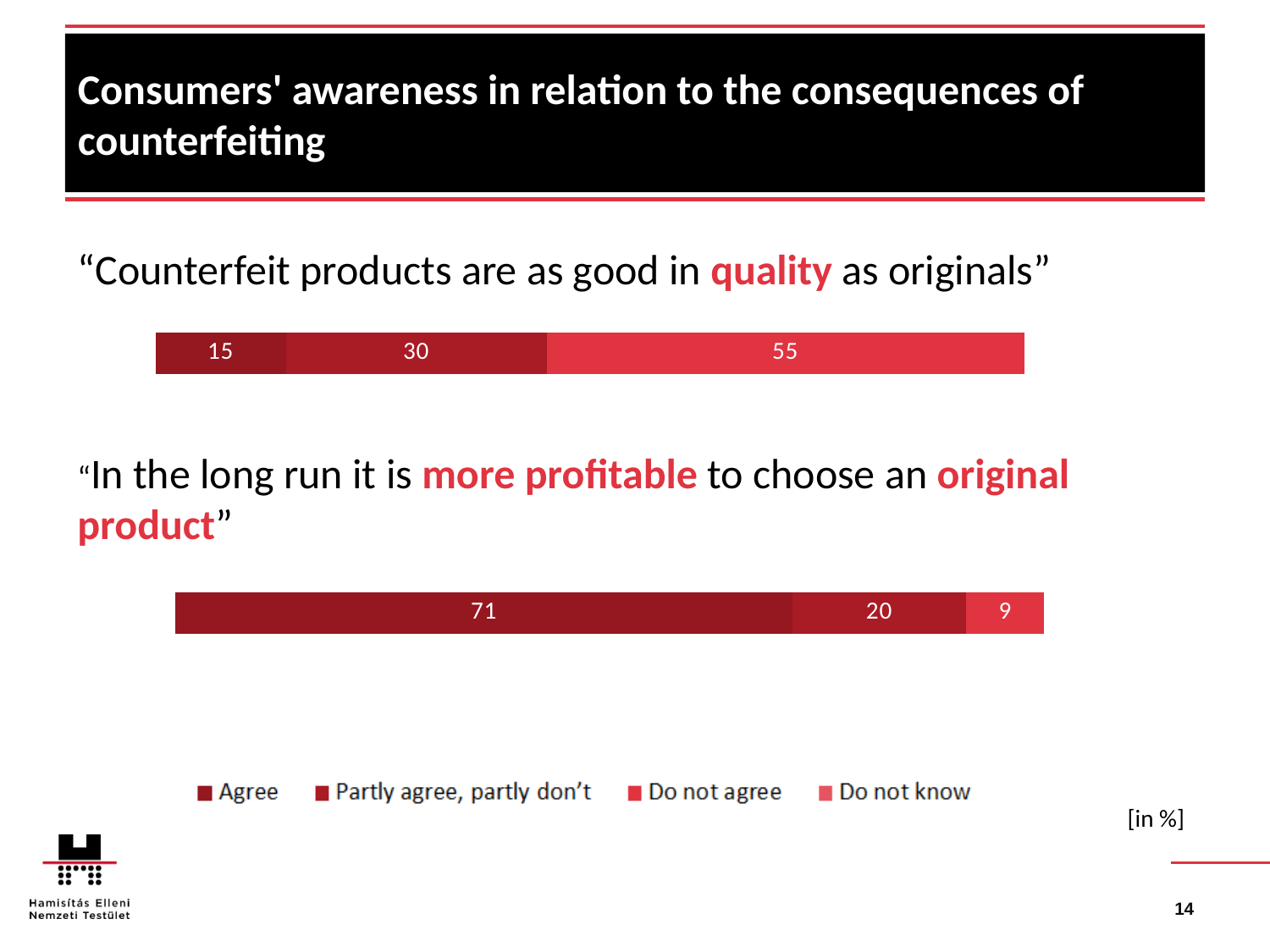
What is the total of the stacked bar in the chart for "In the long run it is more profitable to choose an original product"? 100 How many series does the legend at the bottom of the slide list? 4 Which is larger: the "Agree" value in the quality chart or the "Agree" value in the more profitable chart? The more profitable chart In the chart for "In the long run it is more profitable to choose an original product", which response has the smallest segment? Do not agree In the chart for "Counterfeit products are as good in quality as originals", what is the difference between the "Do not agree" and "Partly agree, partly don't" values? 25 In the chart for "In the long run it is more profitable to choose an original product", what is the value of the "Partly agree, partly don't" segment? 20 In the chart for "Counterfeit products are as good in quality as originals", what is the value of the "Do not agree" segment? 55 In the chart for "Counterfeit products are as good in quality as originals", which response has the largest segment? Do not agree In the chart for "In the long run it is more profitable to choose an original product", what is the difference between the "Agree" and "Partly agree, partly don't" values? 51 In the chart for "In the long run it is more profitable to choose an original product", what is the value of the "Agree" segment? 71 What kind of chart is used on this slide? Stacked bar chart In the chart for "Counterfeit products are as good in quality as originals", what is the value of the "Agree" segment? 15